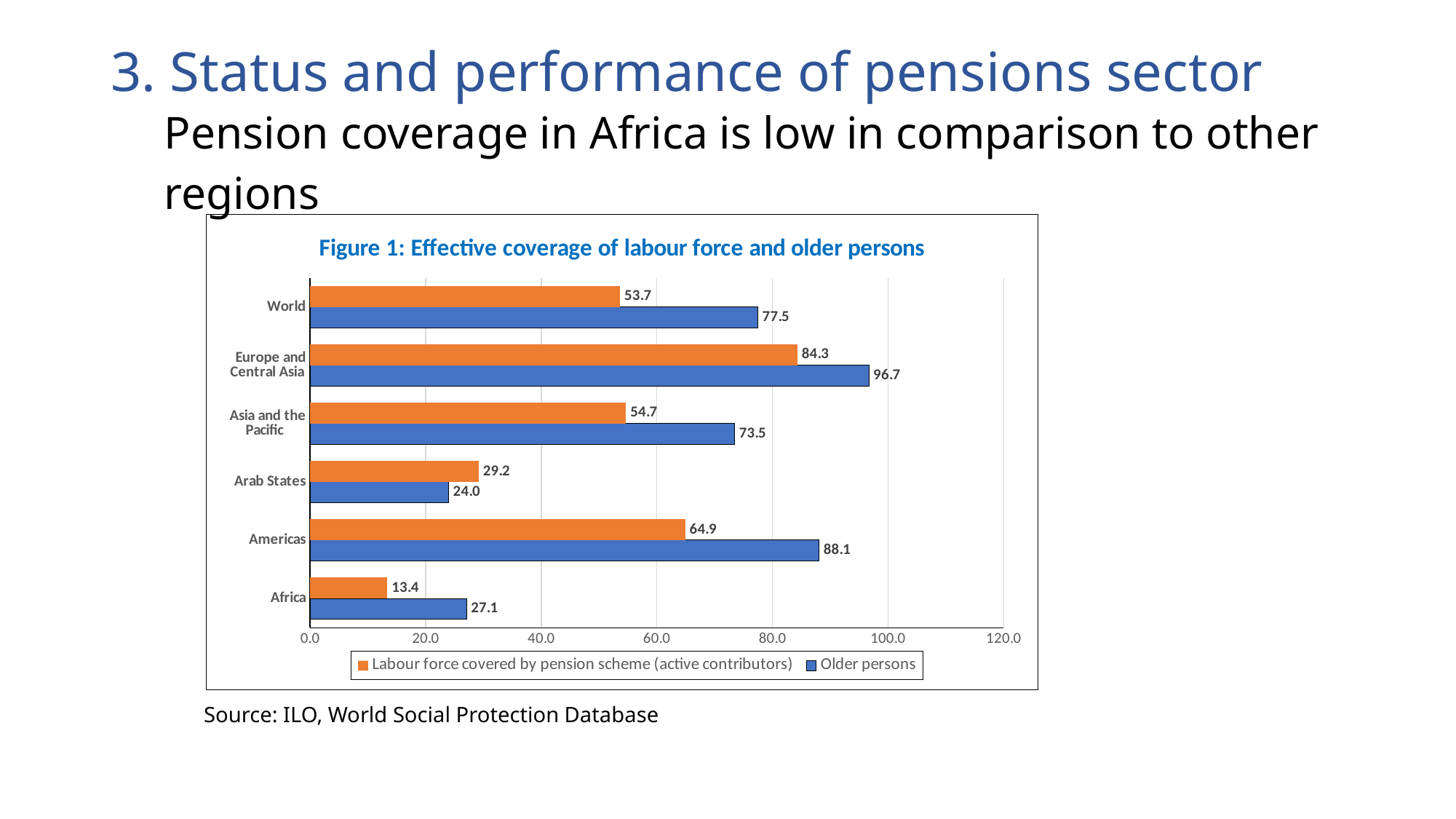
What is the difference between the Older persons value and the Labour force covered value for the World? 23.8 How many series does the legend list? 2 What is the value for Labour force covered by pension scheme (active contributors) in Europe and Central Asia? 84.3 Which region has the lowest value for Labour force covered by pension scheme (active contributors)? Africa How many regions are shown on the chart? 6 Which region has the highest value for Older persons? Europe and Central Asia What is the value for Older persons in the Americas? 88.1 What kind of chart is shown? Bar chart In the Arab States, which is larger: the Labour force covered value or the Older persons value? Labour force covered by pension scheme (active contributors) What is the title of the chart? Figure 1: Effective coverage of labour force and older persons Is the value for Older persons in Asia and the Pacific greater or less than 60.0? greater What is the value for Older persons in Africa? 27.1